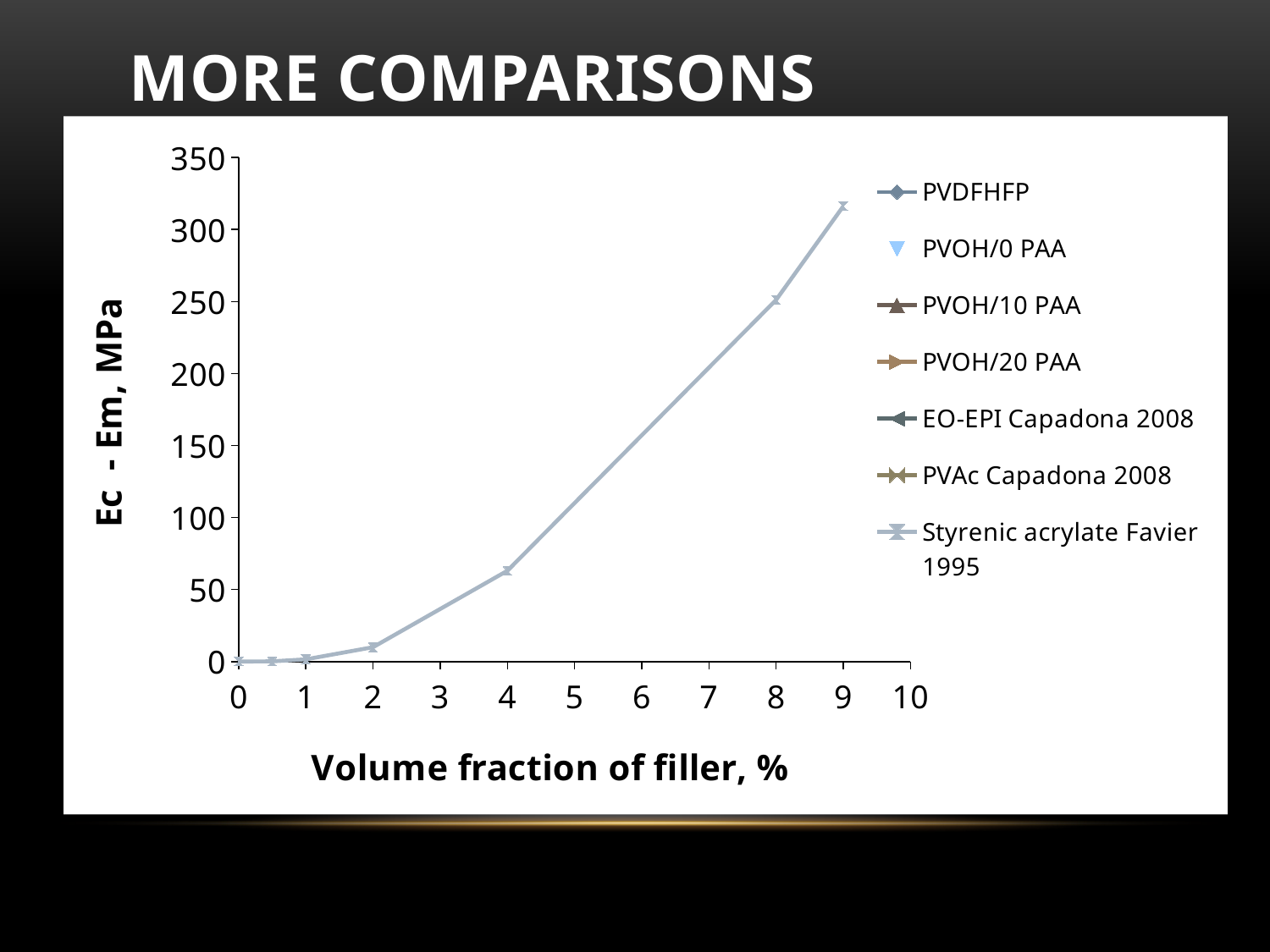
What is the label of the y axis? Ec - Em, MPa What is the label of the x axis? Volume fraction of filler, % Is the value of the plotted series at a volume fraction of 4% greater or less than 100? less Is the value of the plotted series at a volume fraction of 9% greater or less than 300? greater Which is larger for the plotted series: the value at a volume fraction of 9% or at 4%? 9% Does the plotted Styrenic acrylate Favier 1995 series rise or fall as the volume fraction of filler increases? rises At which volume fraction of filler does the plotted series reach its highest value? 9 How many series does the legend list? 7 Is the value of the plotted series at a volume fraction of 2% greater or less than 50? less What kind of chart is shown on the slide? line chart